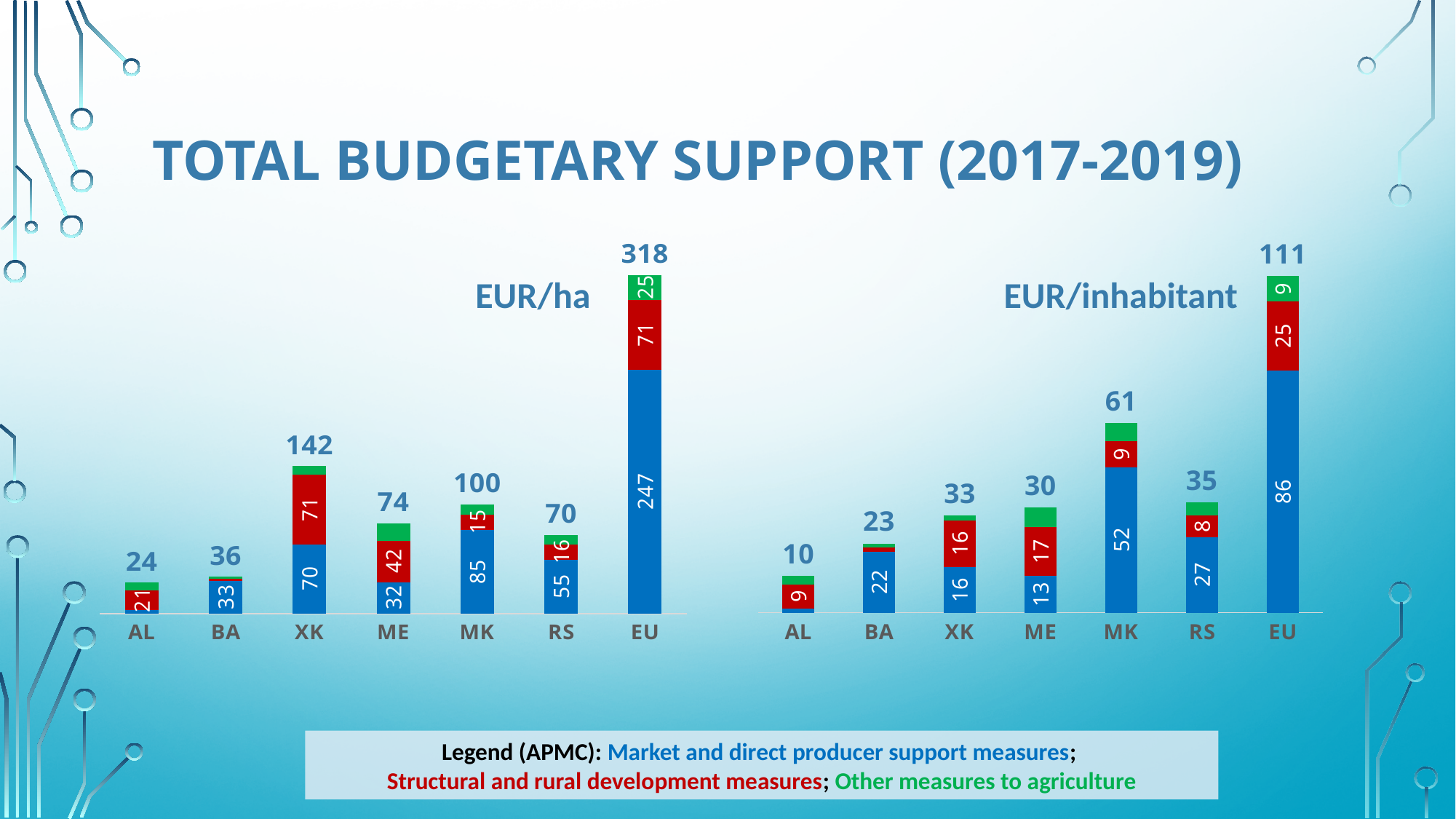
In the EUR/inhabitant chart, which category has the lowest total? AL How many categories are shown on the x axis of the EUR/ha chart? 7 In the EUR/inhabitant chart, what is the total budgetary support for MK? 61 How many series does the legend list? 3 What kind of chart is the EUR/inhabitant chart? Stacked bar chart In the EUR/inhabitant chart, what is the value of the Structural and rural development measures segment for ME? 17 In the EUR/ha chart, what is the difference between the totals for MK and RS? 30 In the EUR/ha chart, what is the total budgetary support for XK? 142 Which colour represents Other measures to agriculture in the legend? Green In the EUR/inhabitant chart, which has a larger total, XK or RS? RS In the EUR/ha chart, what is the value of the Market and direct producer support measures segment for EU? 247 In the EUR/ha chart, which category has the highest total? EU